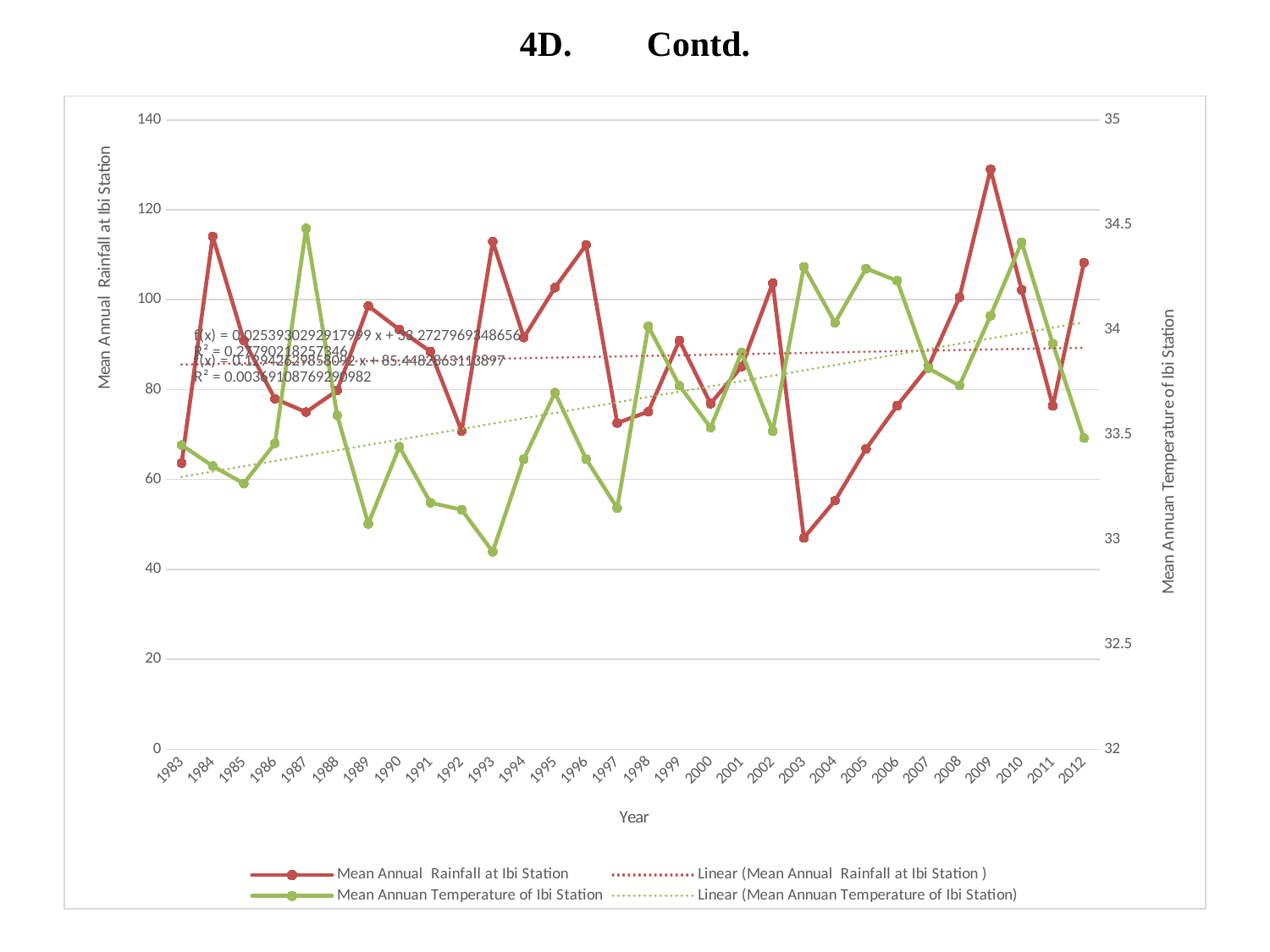
In which year is the Mean Annuan Temperature of Ibi Station lowest? 1993 How many years are plotted along the x axis? 30 What kind of chart is shown on the slide? line chart In which year is the Mean Annuan Temperature of Ibi Station highest? 1987 In which year is the Mean Annual Rainfall at Ibi Station lowest? 2003 What is the title of the x axis? Year Is the Mean Annual Rainfall at Ibi Station in 2009 greater or less than 120? greater Is the Mean Annual Rainfall at Ibi Station in 2003 greater or less than 60? less In which year is the Mean Annual Rainfall at Ibi Station highest? 2009 Is the Mean Annuan Temperature of Ibi Station in 1987 greater or less than 34? greater How many entries does the legend list? 4 Which year has the higher Mean Annual Rainfall at Ibi Station, 1984 or 1985? 1984